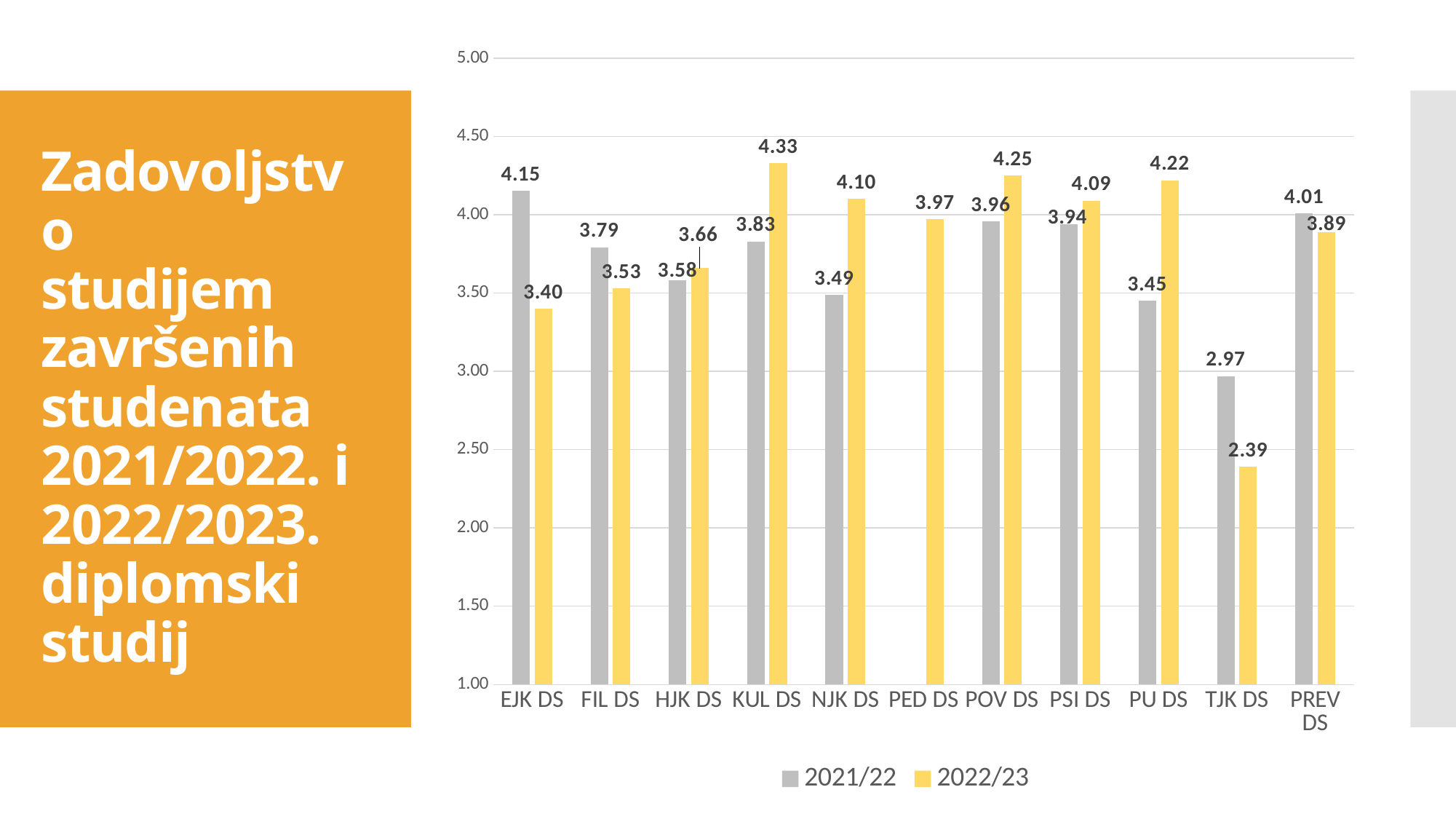
What is the difference between the 2022/23 and 2021/22 values for KUL DS? 0.50 Which category has the highest 2022/23 value? KUL DS What is the 2021/22 value for EJK DS? 4.15 How many categories are shown on the x axis? 11 What is the 2022/23 value for TJK DS? 2.39 Is the 2021/22 value for TJK DS greater or less than 3.00? less What type of chart is shown on the slide? bar chart Which is larger for PREV DS, the 2021/22 value or the 2022/23 value? 2021/22 Which category has the lowest 2021/22 value? TJK DS How many series does the legend list? 2 What is the 2022/23 value for KUL DS? 4.33 Which series is shown in yellow in the legend? 2022/23